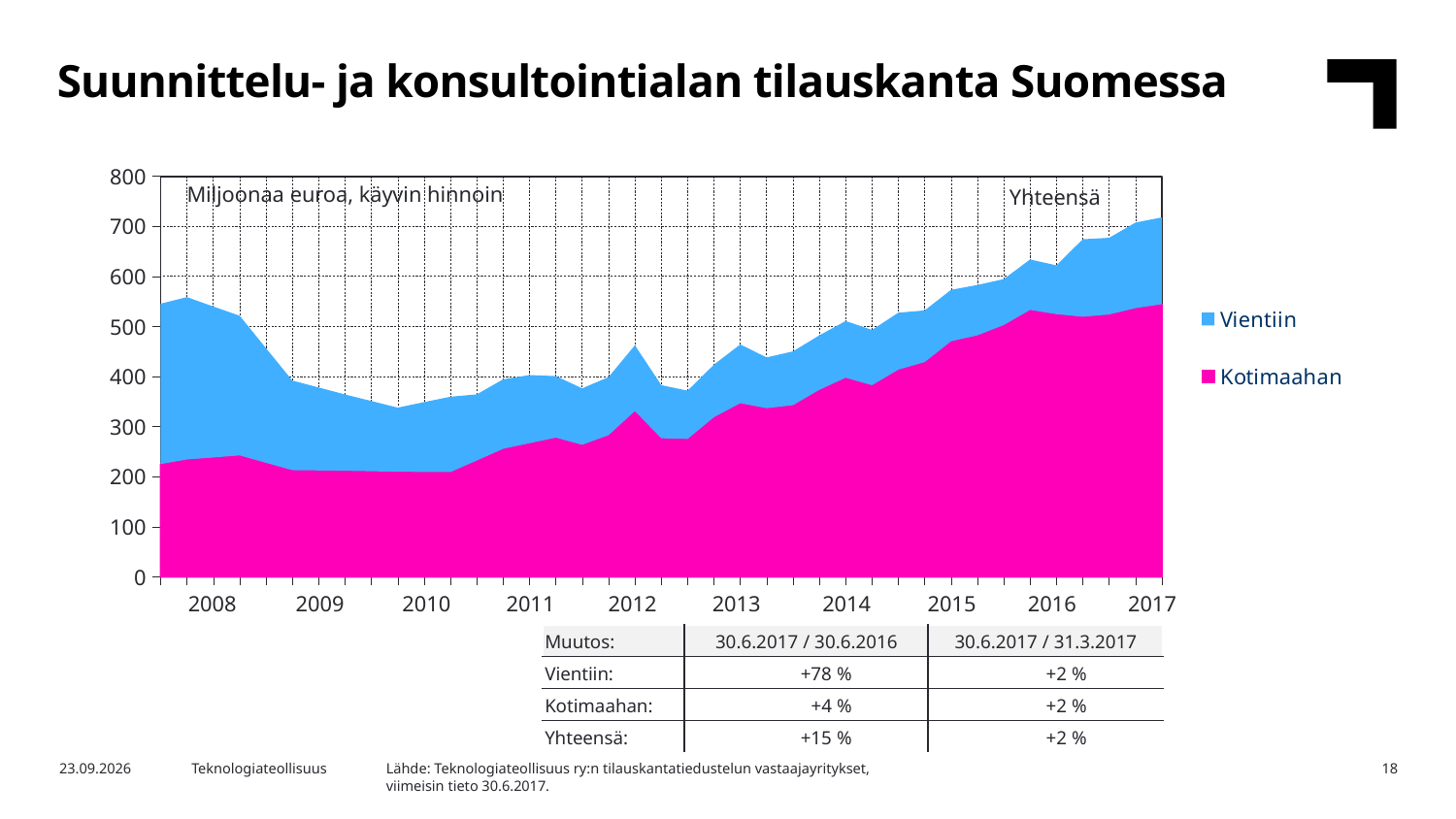
Is the total (Yhteensä) value at the start of 2016 greater or less than 600? greater Which is larger in 2017, the Vientiin portion or the Kotimaahan portion? Kotimaahan Which colour represents Kotimaahan in the chart? Magenta (pink) Is the total (Yhteensä) value at the end of the series in 2017 greater or less than 700? greater What are the two series named in the chart legend? Vientiin and Kotimaahan Does the Kotimaahan value rise or fall from 2013 to 2017? rise How many series does the chart legend list? 2 Is the Kotimaahan value at the start of 2017 greater or less than 500? greater Does the total (Yhteensä) value rise or fall from 2008 to 2010? fall What kind of chart is shown on the slide? Stacked area chart